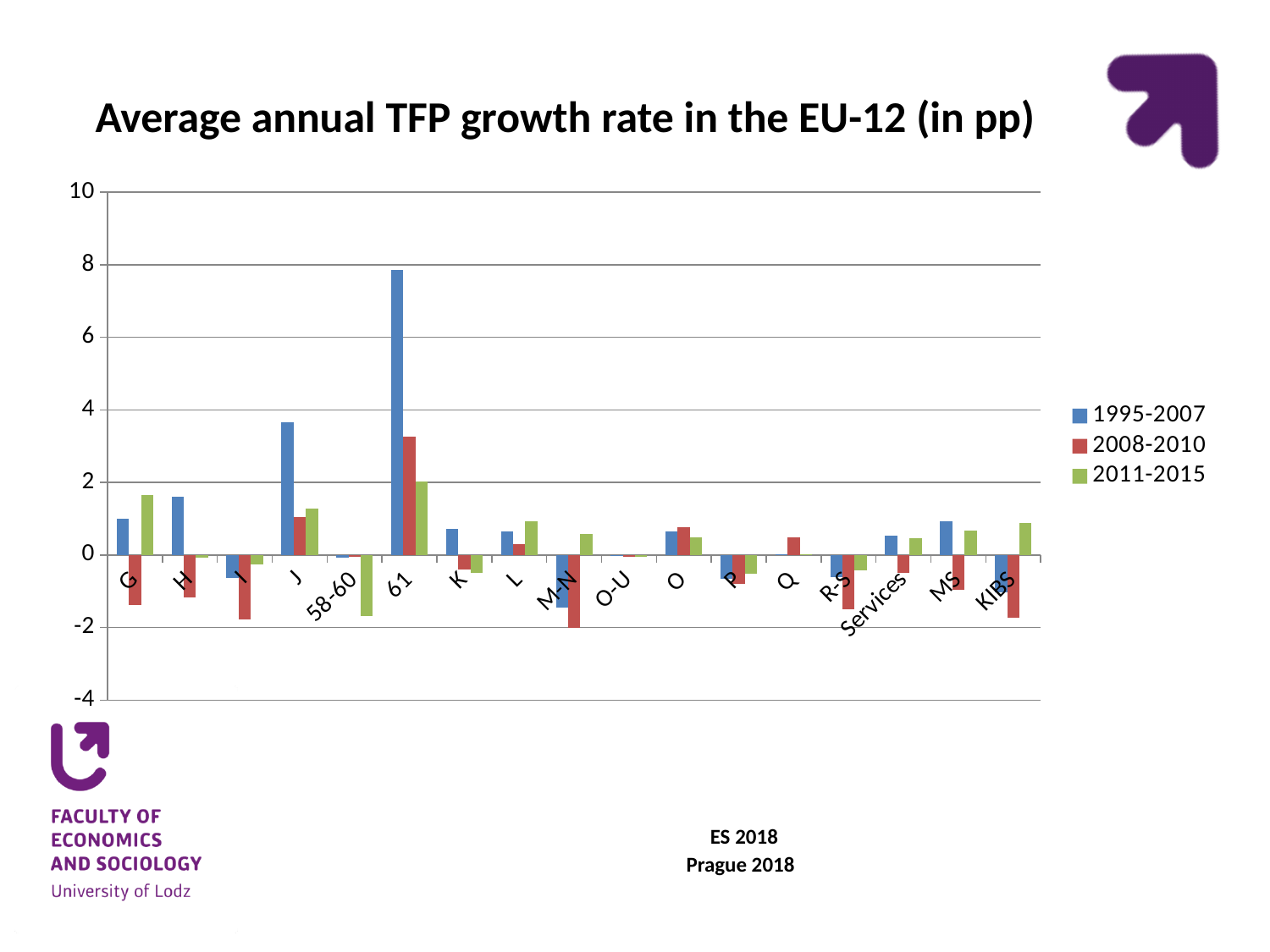
Which period does the green series in the legend represent? 2011-2015 How many series does the legend list? 3 What is the title of the chart? Average annual TFP growth rate in the EU-12 (in pp) Is the 1995-2007 value for J greater or less than 2? greater Is the 1995-2007 value for 61 greater or less than 6? greater Is the 2011-2015 value for 58-60 greater or less than -1? less Which category has the highest value for the 1995-2007 series? 61 For the 1995-2007 series, which is larger: the value for J or the value for H? J How many categories are shown on the x axis? 17 What kind of chart is shown on the slide? bar chart